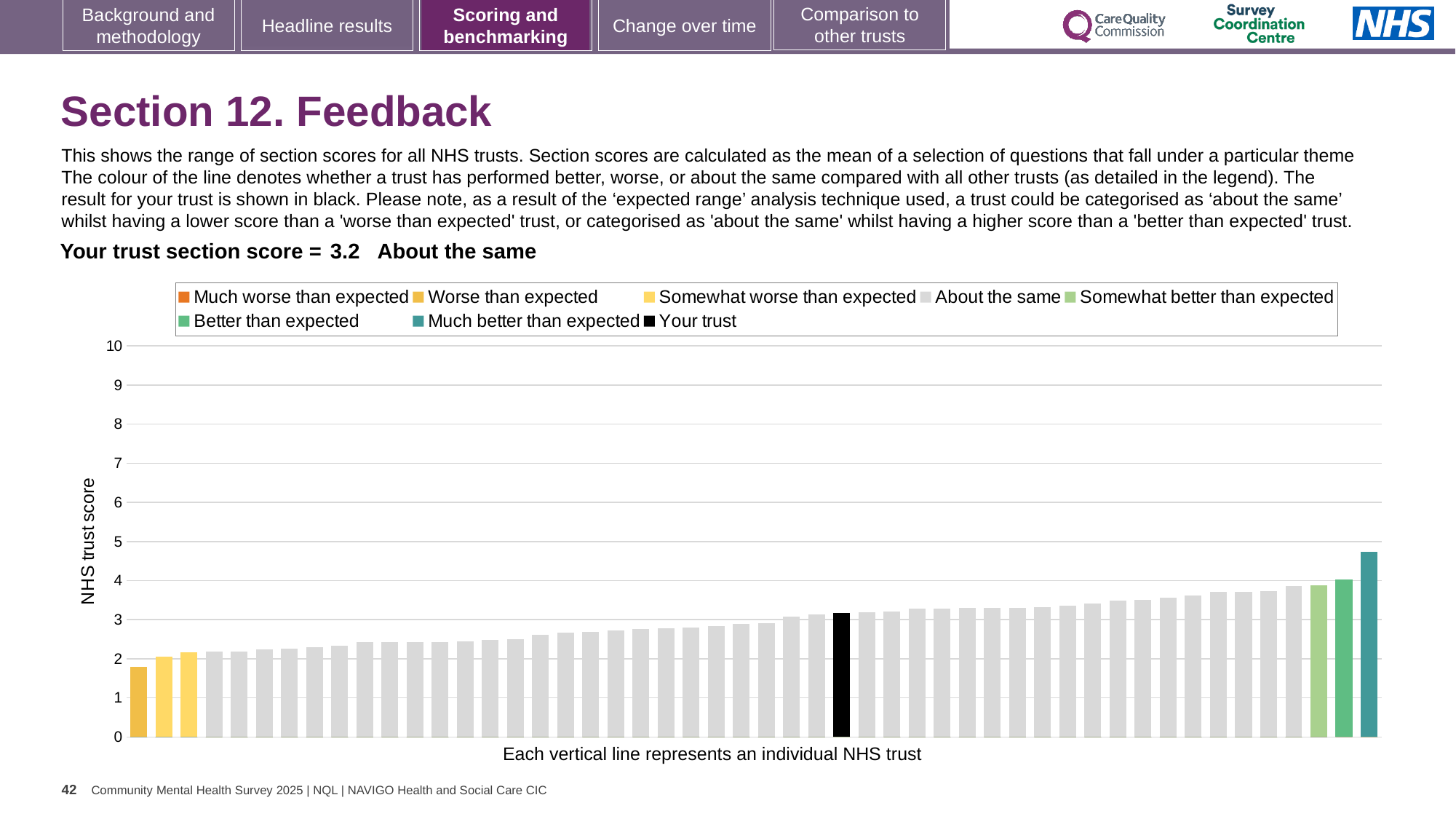
How many entries does the chart legend list? 8 How many bars are coloured as 'Much better than expected'? 1 What is the label on the y axis of the chart? NHS trust score Which performance category is your trust placed in for this section? About the same Is the value of the tallest bar (the rightmost, teal bar) greater or less than 4? greater What is the section score for your trust? 3.2 Do the bar values rise or fall moving from left to right along the x axis? rise What kind of chart is shown on the slide? bar chart Is the value of the leftmost (lowest) bar greater or less than 2? less Is the value of the black 'Your trust' bar greater or less than 3? greater Which legend category does the highest-scoring trust belong to? Much better than expected